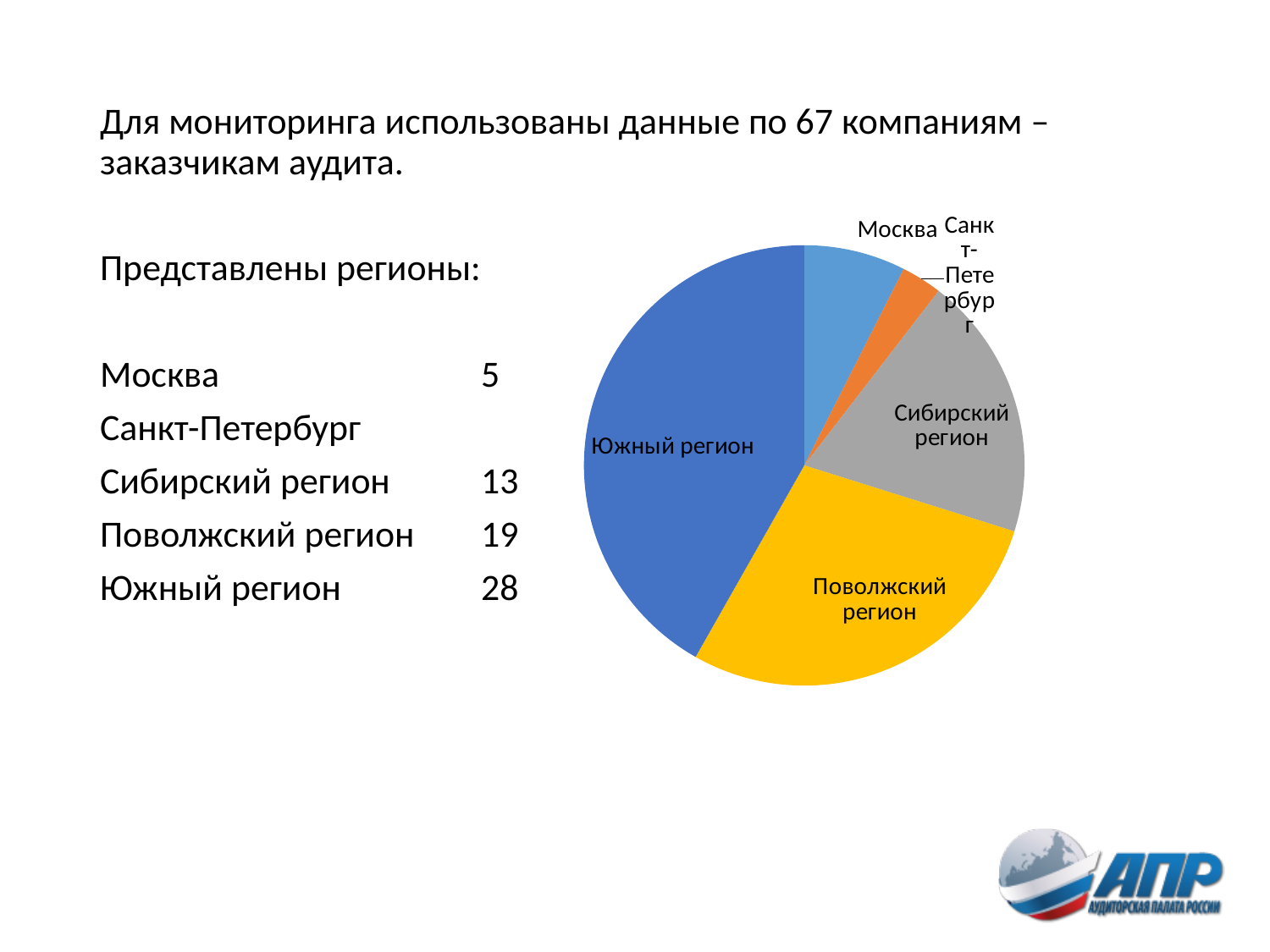
What kind of chart is shown on the slide? pie chart Which slice is larger, Москва or Южный регион? Южный регион What is the difference between the number of companies from Южный регион and from Поволжский регион? 9 Which region has the smallest slice in the pie chart? Санкт-Петербург According to the slide, how many companies are from Сибирский регион? 13 Which region has the largest slice in the pie chart? Южный регион Which slice is larger, Поволжский регион or Сибирский регион? Поволжский регион How many slices (regions) does the pie chart have? 5 According to the slide, how many companies are from Южный регион? 28 According to the slide, how many companies are from Москва? 5 What colour is the Южный регион slice in the pie chart? blue According to the slide, how many companies are from Поволжский регион? 19